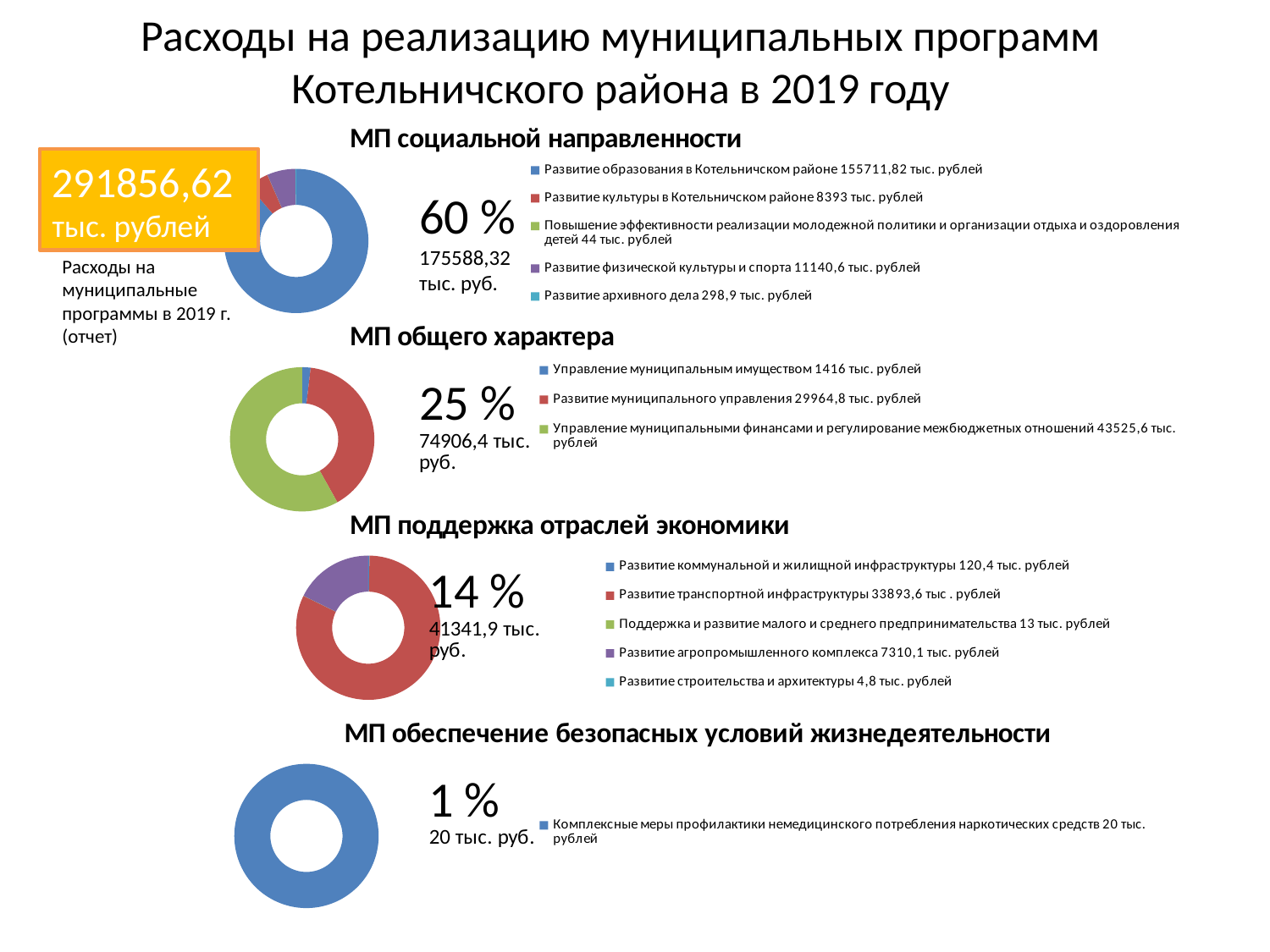
In the "МП поддержка отраслей экономики" chart, which category has the smallest value? Развитие строительства и архитектуры What share of total expenditure does the "МП общего характера" chart represent, according to the slide? 25 % In the "МП поддержка отраслей экономики" chart, what is the value for "Развитие агропромышленного комплекса"? 7310,1 тыс. рублей In the "МП поддержка отраслей экономики" chart, which is larger: "Развитие транспортной инфраструктуры" or "Развитие коммунальной и жилищной инфраструктуры"? Развитие транспортной инфраструктуры In the "МП социальной направленности" chart, what is the value for "Развитие образования в Котельничском районе"? 155711,82 тыс. рублей In the "МП общего характера" chart, what is the difference between "Управление муниципальными финансами и регулирование межбюджетных отношений" and "Развитие муниципального управления"? 13560,8 тыс. рублей What kind of chart is used for "МП социальной направленности"? Doughnut (pie) chart What total amount is shown next to the "МП поддержка отраслей экономики" chart? 41341,9 тыс. руб. How many categories does the legend of the "МП обеспечение безопасных условий жизнедеятельности" chart list? 1 In the "МП общего характера" chart, which category has the largest value? Управление муниципальными финансами и регулирование межбюджетных отношений In the "МП социальной направленности" chart, which category has the smallest value? Повышение эффективности реализации молодежной политики и организации отдыха и оздоровления детей How many categories does the legend of the "МП социальной направленности" chart list? 5